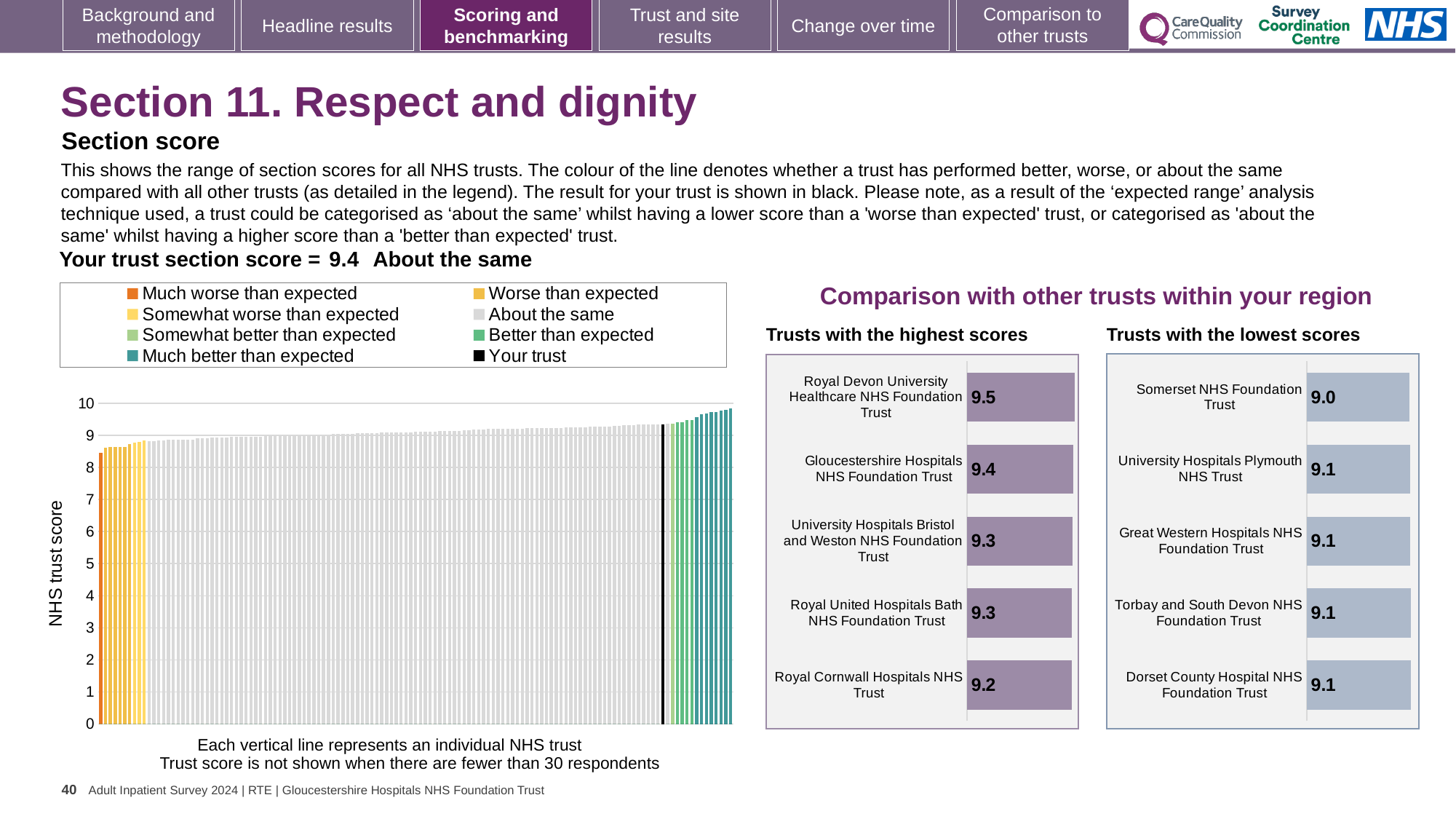
In the 'Trusts with the highest scores' chart, what is the difference between the scores of Royal Devon University Healthcare NHS Foundation Trust and Royal Cornwall Hospitals NHS Trust? 0.3 In the 'Trusts with the lowest scores' chart, which has the higher score: Somerset NHS Foundation Trust or University Hospitals Plymouth NHS Trust? University Hospitals Plymouth NHS Trust In the 'Trusts with the highest scores' chart, what is the score for Royal Cornwall Hospitals NHS Trust? 9.2 In the 'Trusts with the highest scores' chart, what is the score for Royal Devon University Healthcare NHS Foundation Trust? 9.5 How many trusts are listed in the 'Trusts with the highest scores' chart? 5 How many entries does the legend of the large chart on the left list? 8 In the 'Trusts with the lowest scores' chart, what is the score for Somerset NHS Foundation Trust? 9.0 In the large chart on the left, is the value of the leftmost (orange) bar greater or less than 8? greater In the large chart on the left, do the NHS trust scores rise or fall from left to right? Rise In the 'Trusts with the highest scores' chart, which trust has the highest score? Royal Devon University Healthcare NHS Foundation Trust In the 'Trusts with the lowest scores' chart, which trust has the lowest score? Somerset NHS Foundation Trust What type of chart is the large chart on the left showing NHS trust scores? Bar chart